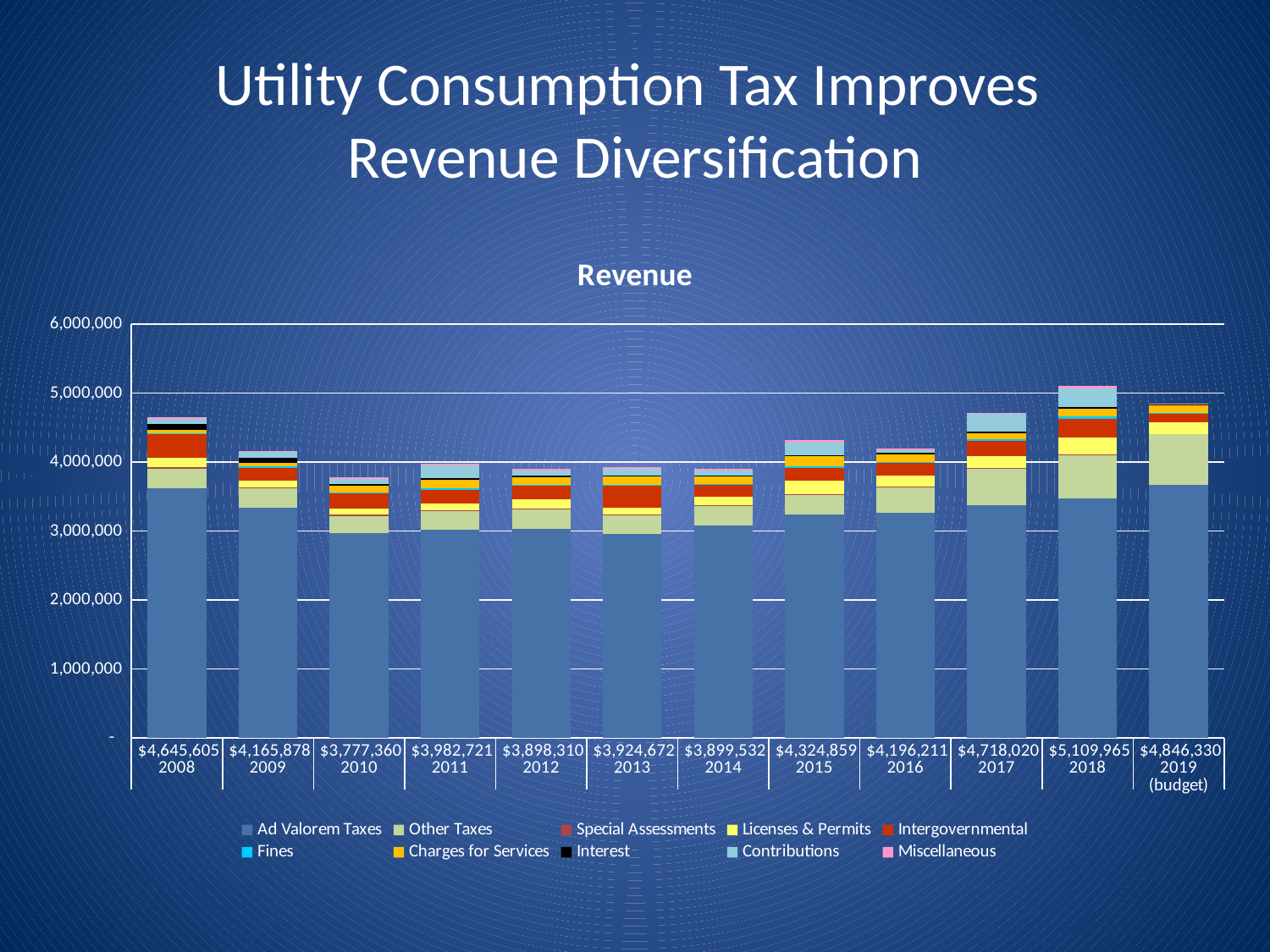
What is the total revenue shown for 2010? $3,777,360 How many years (bars) are shown in the chart? 12 What is the total revenue shown for 2019 (budget)? $4,846,330 Is the Ad Valorem Taxes value for 2008 greater or less than 3,000,000? greater What is the difference between the total revenue in 2018 and in 2010? $1,332,605 What is the total of the stacked bar for 2015? $4,324,859 Which year has the highest total revenue? 2018 Which year has the lowest total revenue? 2010 Which year has the larger total revenue, 2012 or 2013? 2013 What kind of chart is shown on the slide? Stacked bar chart How many series does the legend list? 10 What is the total revenue shown for 2018? $5,109,965